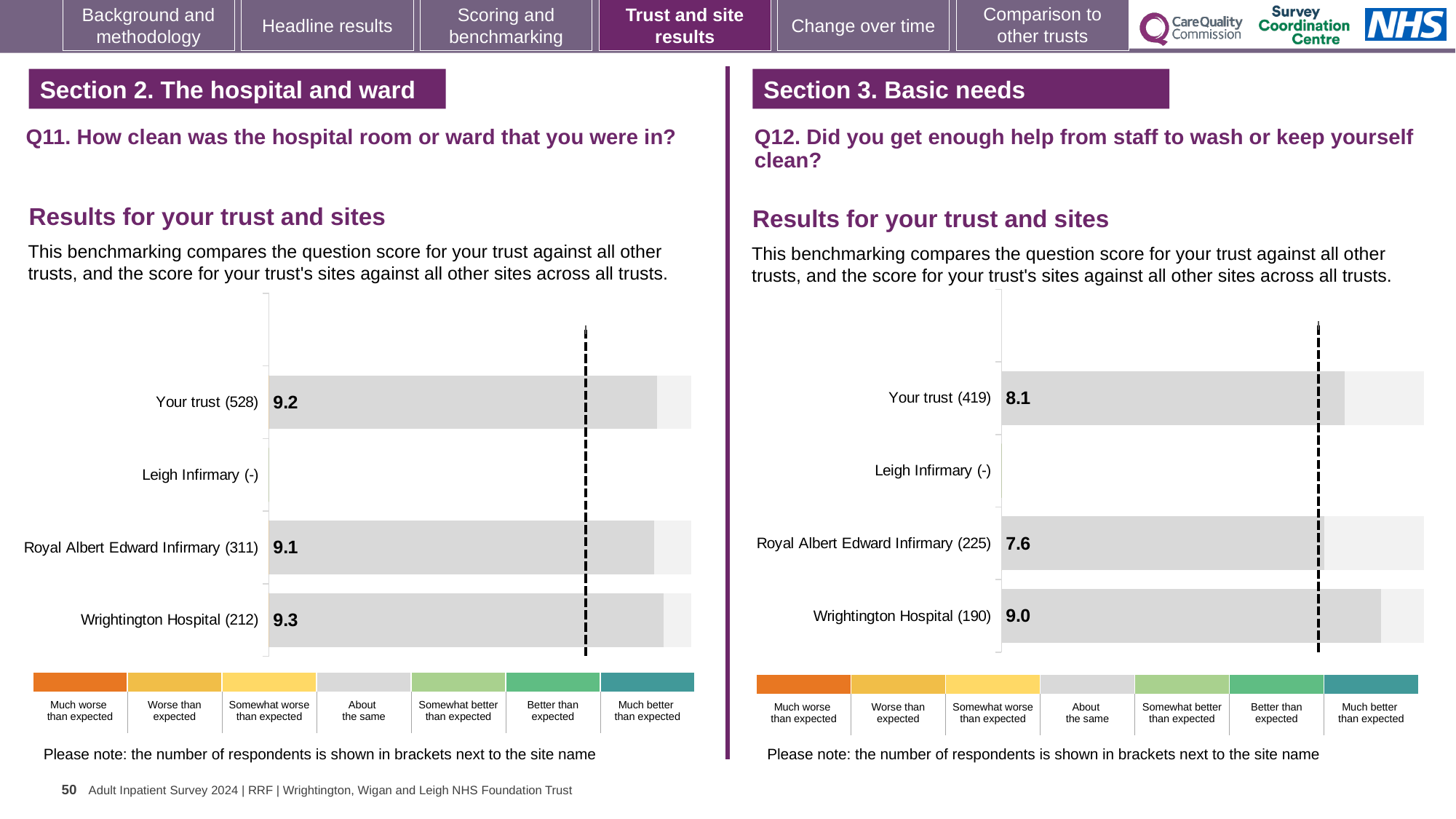
In the Q11 chart (left), which has the higher score, Your trust or Royal Albert Edward Infirmary? Your trust What type of chart is used for the Q12 results (right)? Bar chart In the Q11 chart (left), what is the difference between the scores for Wrightington Hospital and Royal Albert Edward Infirmary? 0.2 In the Q11 chart (left), what is the score for Your trust? 9.2 In the Q12 chart (right), which site or trust has the highest score? Wrightington Hospital In the Q12 chart (right), what is the difference between the scores for Wrightington Hospital and Your trust? 0.9 In the Q12 chart (right), what is the score for Royal Albert Edward Infirmary? 7.6 In the Q12 chart (right), how many respondents are shown in brackets for Your trust? 419 How many rows (trust and sites) are listed in the Q11 chart (left)? 4 In the Q12 chart (right), which site or trust has the lowest score? Royal Albert Edward Infirmary In the Q11 chart (left), what is the score for Wrightington Hospital? 9.3 In the Q12 chart (right), what is the score for Wrightington Hospital? 9.0